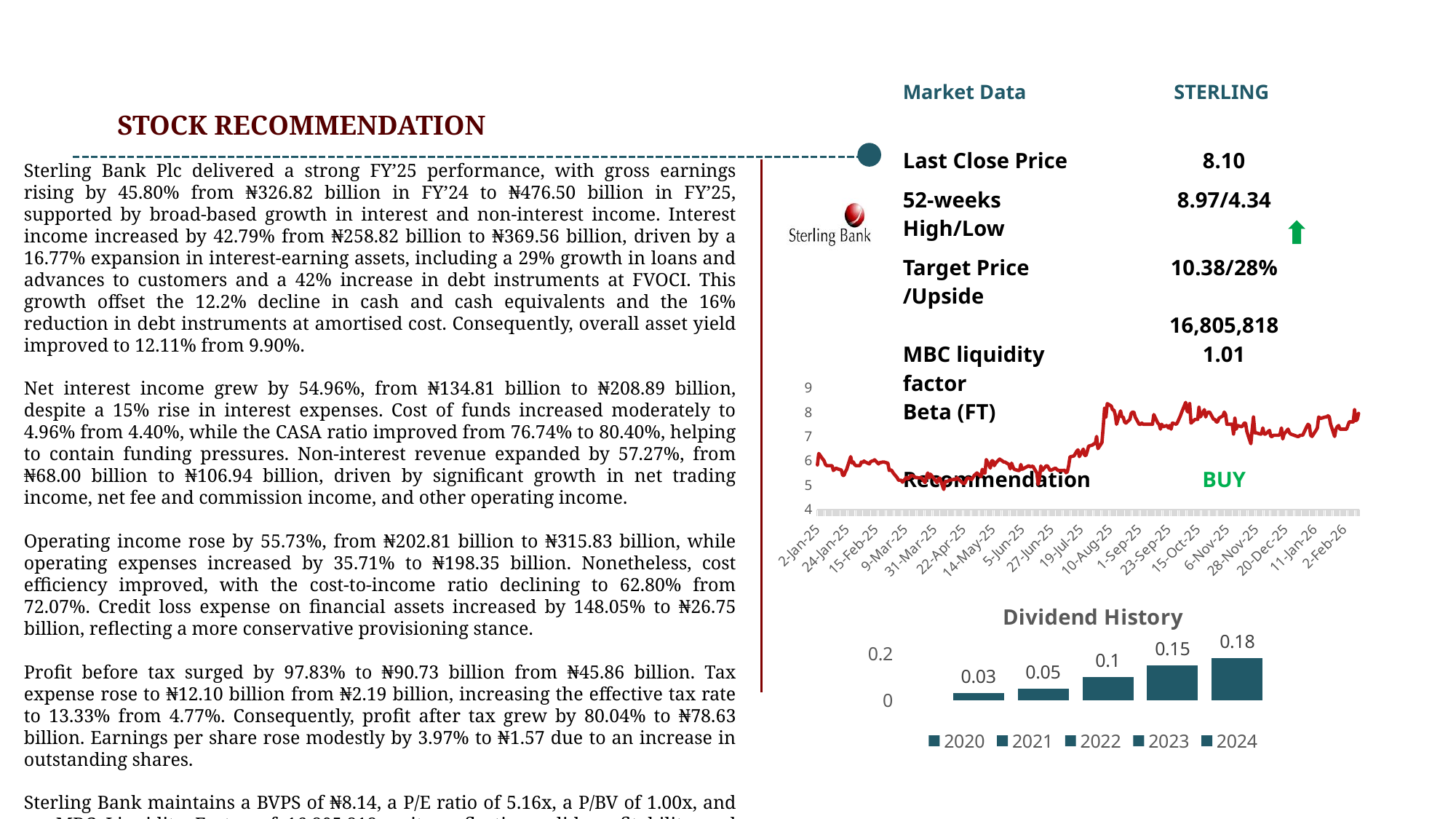
On the stock price chart above the Dividend History chart, is the value at 2-Jan-25 greater or less than 5? greater On the Dividend History chart, which year has the highest dividend? 2024 On the Dividend History chart, which year has the lowest dividend? 2020 What kind of chart is the Dividend History chart? bar chart On the Dividend History chart, what is the dividend value for 2022? 0.1 On the Dividend History chart, what is the dividend value for 2020? 0.03 On the Dividend History chart, which is larger, the dividend for 2021 or for 2022? 2022 On the Dividend History chart, how many years are shown? 5 On the Dividend History chart, what is the difference between the 2024 and 2023 dividend values? 0.03 On the Dividend History chart, what is the dividend value for 2024? 0.18 On the Dividend History chart, how many entries does the legend list? 5 On the Dividend History chart, do the dividend values rise or fall from 2020 to 2024? rise